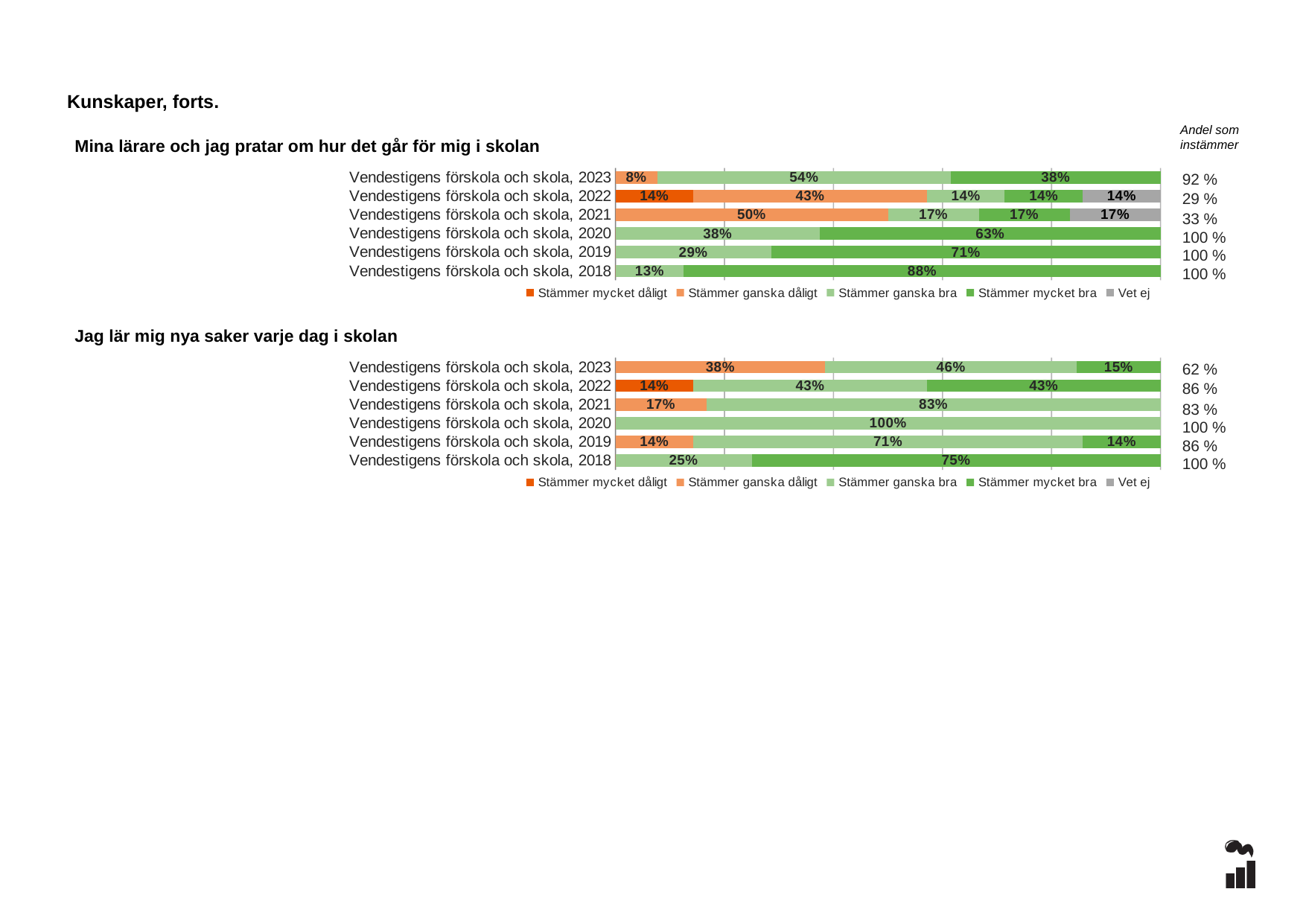
What kind of chart is 'Jag lär mig nya saker varje dag i skolan'? Stacked bar chart In the chart 'Jag lär mig nya saker varje dag i skolan', what is the 'Stämmer ganska dåligt' value for Vendestigens förskola och skola, 2023? 38% In the chart 'Mina lärare och jag pratar om hur det går för mig i skolan', what is the 'Stämmer ganska dåligt' value for Vendestigens förskola och skola, 2021? 50% In the chart 'Jag lär mig nya saker varje dag i skolan', which is larger: the 'Stämmer mycket bra' value for 2022 or for 2023? 2022 How many series does the legend of the chart 'Jag lär mig nya saker varje dag i skolan' list? 5 In the chart 'Mina lärare och jag pratar om hur det går för mig i skolan', what is the 'Andel som instämmer' value for Vendestigens förskola och skola, 2022? 29 % In the chart 'Jag lär mig nya saker varje dag i skolan', what is the 'Stämmer ganska bra' value for Vendestigens förskola och skola, 2020? 100% In the chart 'Mina lärare och jag pratar om hur det går för mig i skolan', which year has the lowest 'Andel som instämmer'? 2022 In the chart 'Mina lärare och jag pratar om hur det går för mig i skolan', what is the difference between the 'Stämmer mycket bra' values for 2019 and 2023? 33 percentage points How many bars (years) are shown in the chart 'Mina lärare och jag pratar om hur det går för mig i skolan'? 6 In the chart 'Jag lär mig nya saker varje dag i skolan', what is the 'Andel som instämmer' value for Vendestigens förskola och skola, 2021? 83 % In the chart 'Mina lärare och jag pratar om hur det går för mig i skolan', what is the 'Stämmer mycket bra' value for Vendestigens förskola och skola, 2018? 88%